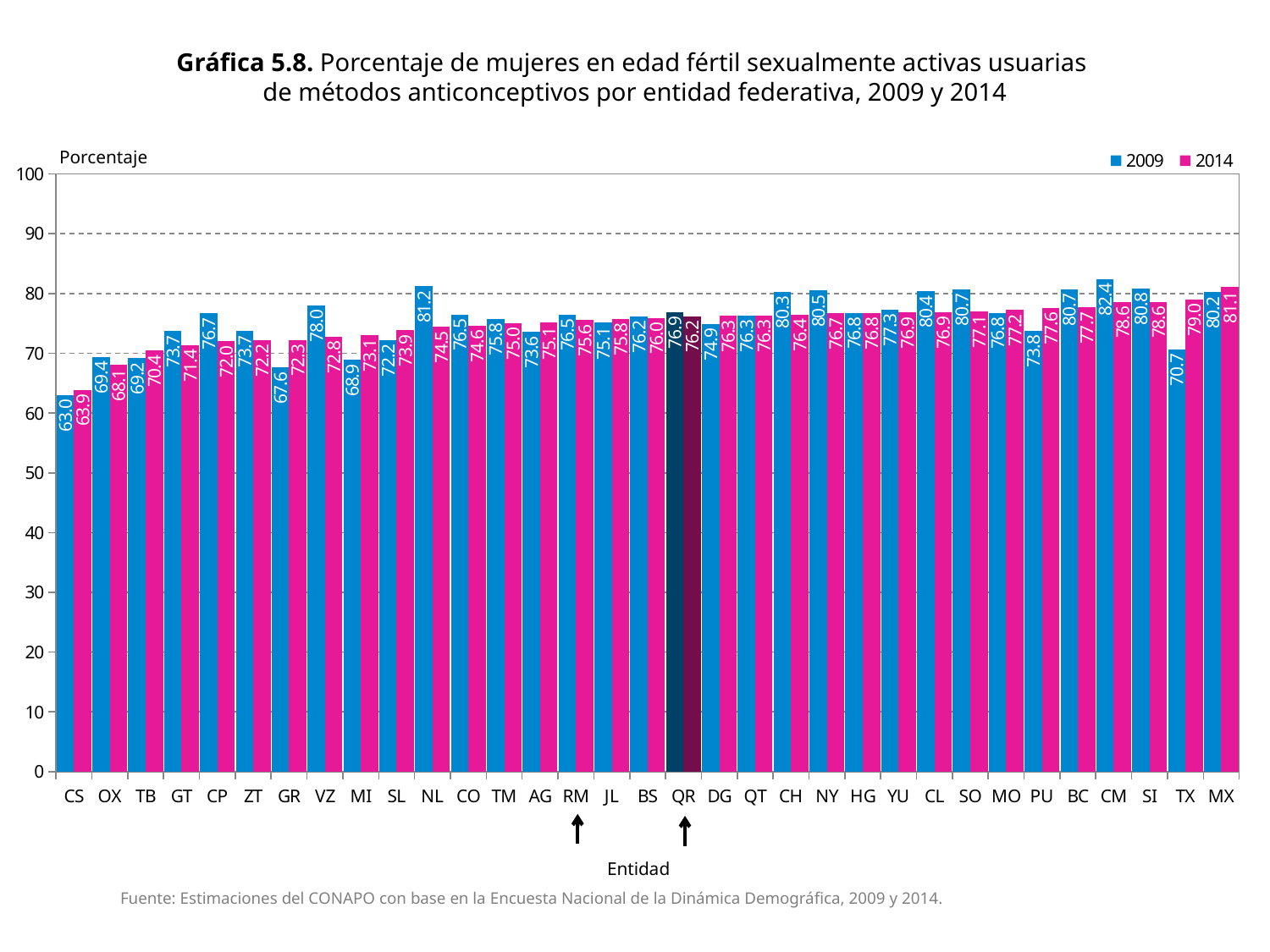
What was the 2014 value for NL? 74.5 Is the 2009 value for NL greater or less than 80? greater How many series does the legend list? 2 Which entity had the highest 2009 value? CM What is the difference between the 2009 and 2014 values for VZ? 5.2 What type of chart is shown? Bar chart What was the 2014 value for QR? 76.2 What was the 2009 value for TX? 70.7 How many entities are shown on the x axis? 33 Which entity had the lowest 2009 value? CS For GR, which year had the larger value, 2009 or 2014? 2014 Which entity had the highest 2014 value? MX